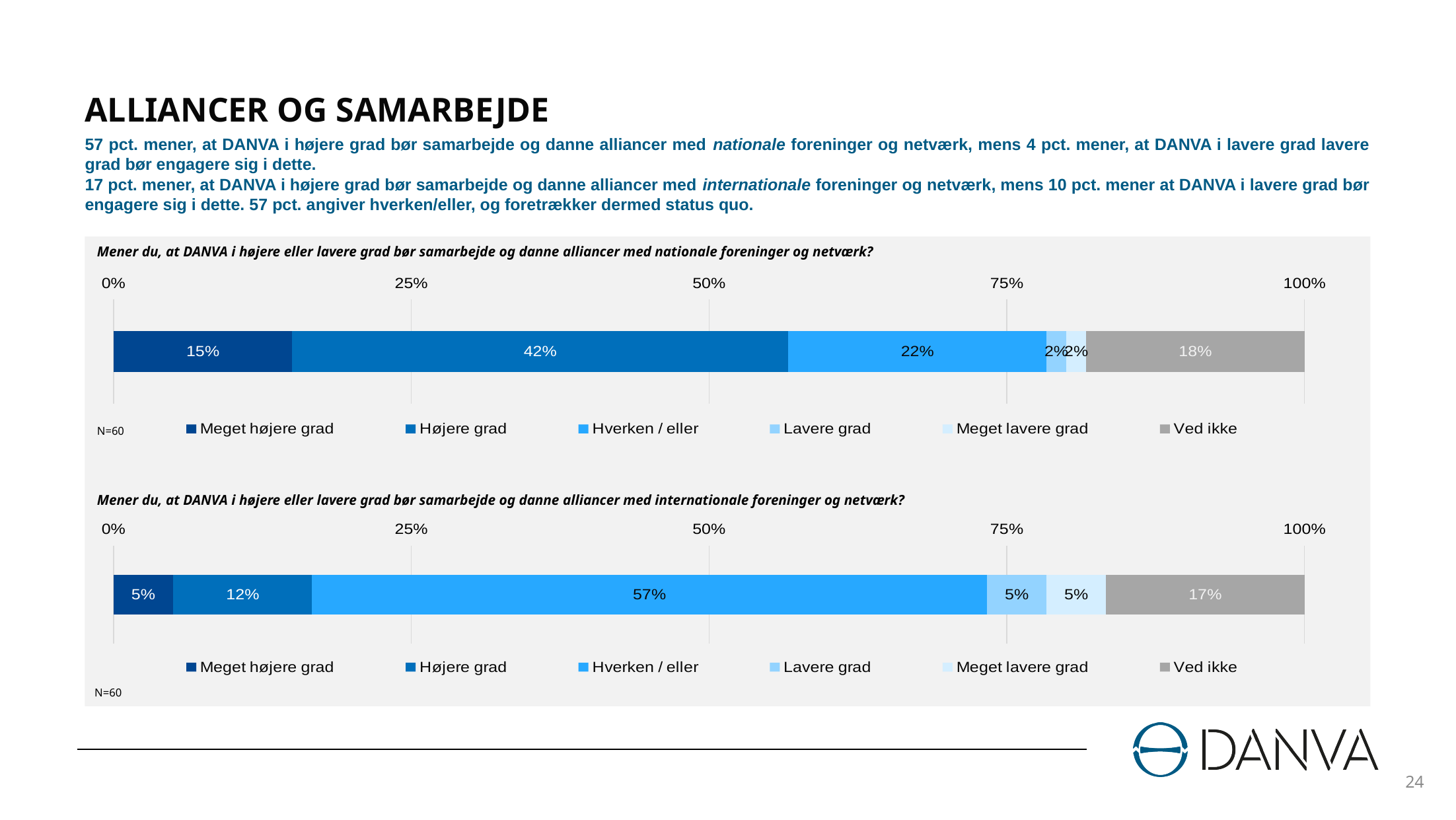
In the chart about nationale foreninger og netværk, which series has the largest share? Højere grad How many series does the legend list in the chart about internationale foreninger og netværk? 6 In the chart about internationale foreninger og netværk, which series has the largest share? Hverken / eller In the chart about internationale foreninger og netværk, what is the difference between Ved ikke and Højere grad? 5% What kind of chart is used for the nationale foreninger og netværk question? Stacked bar chart In the chart about internationale foreninger og netværk, what is the value for Hverken / eller? 57% In the chart about internationale foreninger og netværk, what is the value for Meget højere grad? 5% In the chart about nationale foreninger og netværk, which is larger: Meget højere grad or Ved ikke? Ved ikke What is the sample size (N) shown for the chart about nationale foreninger og netværk? N=60 In the chart about nationale foreninger og netværk, what is the difference between Højere grad and Hverken / eller? 20% In the chart about nationale foreninger og netværk, what is the value for Ved ikke? 18% In the chart about nationale foreninger og netværk, what is the value for Højere grad? 42%